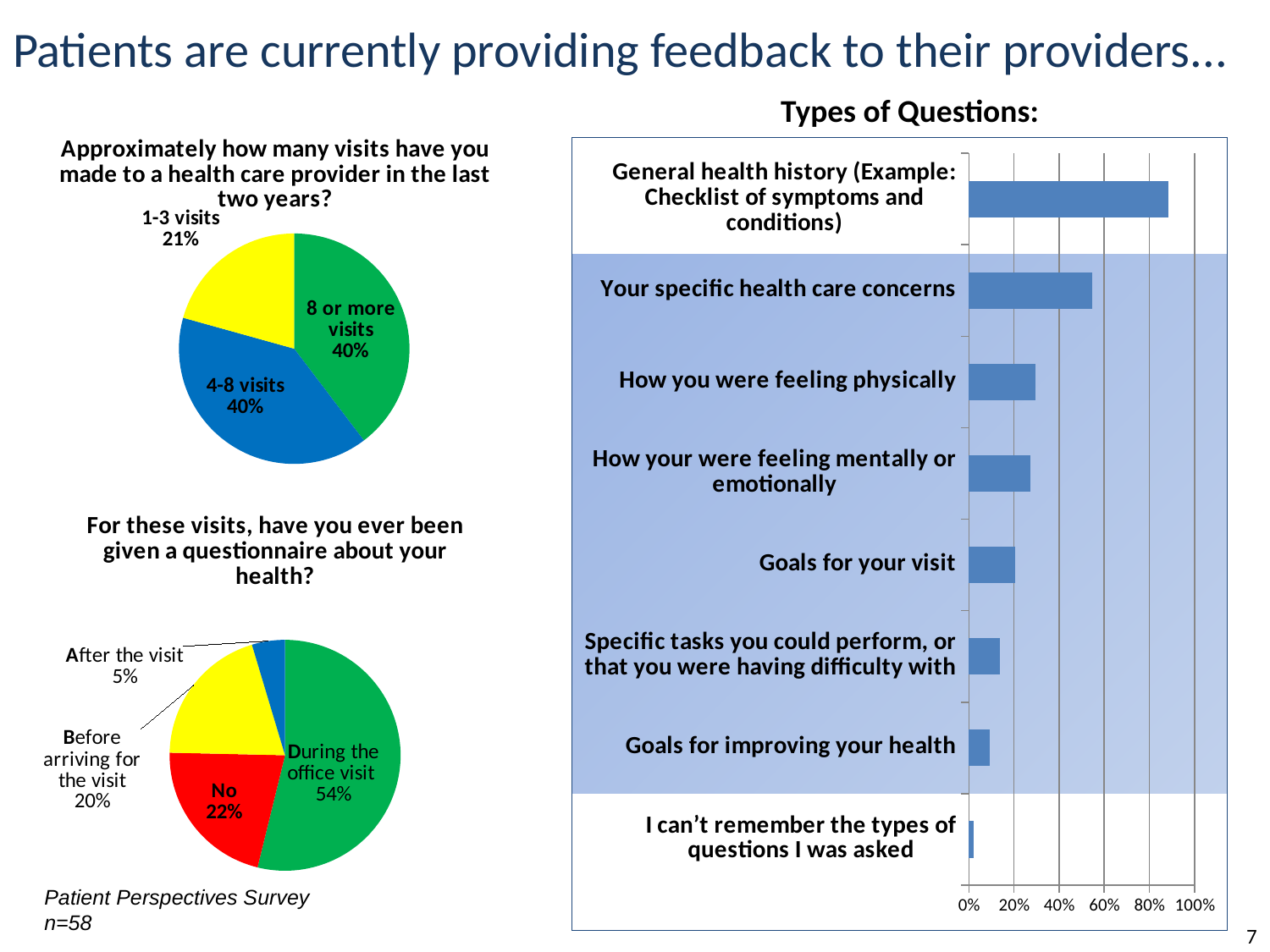
In the pie chart about being given a questionnaire about your health, what share of respondents answered 'No'? 22% In the pie chart about how many visits patients made in the last two years, how many slices does the pie have? 3 In the pie chart about being given a questionnaire about your health, which response has the smallest share? After the visit In the pie chart about how many visits patients made in the last two years, what share of respondents made 1-3 visits? 21% In the 'Types of Questions' bar chart, is the value for 'Your specific health care concerns' greater or less than 40%? greater In the 'Types of Questions' bar chart, how many categories are shown? 8 In the 'Types of Questions' bar chart, is the value for 'Goals for improving your health' greater or less than 20%? less In the pie chart about how many visits patients made in the last two years, what share of respondents made 8 or more visits? 40% In the 'Types of Questions' bar chart, which category has the shortest bar? I can't remember the types of questions I was asked In the 'Types of Questions' bar chart, which category has the longest bar? General health history (Example: Checklist of symptoms and conditions) In the pie chart about being given a questionnaire about your health, which response has the largest share? During the office visit In the pie chart about being given a questionnaire about your health, what is the difference between the 'During the office visit' share and the 'Before arriving for the visit' share? 34%